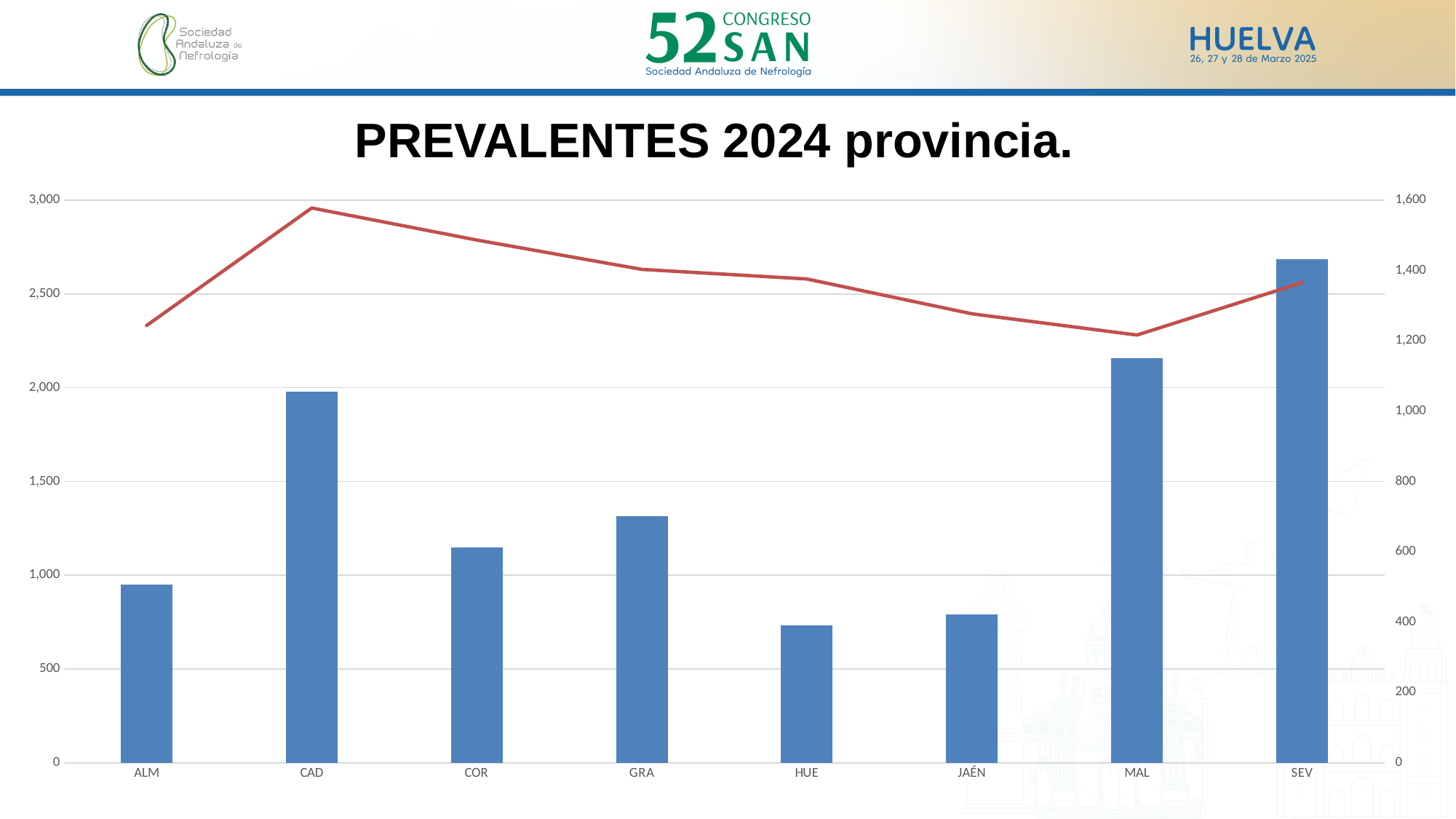
What is the title of the chart? PREVALENTES 2024 provincia. Is the bar value for MAL greater or less than 2,000? greater Is the bar value for ALM greater or less than 1,000? less Which bar is taller, GRA or COR? GRA Which province has the tallest bar? SEV Is the bar value for SEV greater or less than 2,500? greater What kind of chart is shown on the slide? A bar chart combined with a line chart At which province does the red line reach its highest point? CAD Which bar is taller, CAD or MAL? MAL Which province has the shortest bar? HUE Does the red line rise or fall from CAD to MAL? fall How many provinces (categories) are shown on the x axis? 8